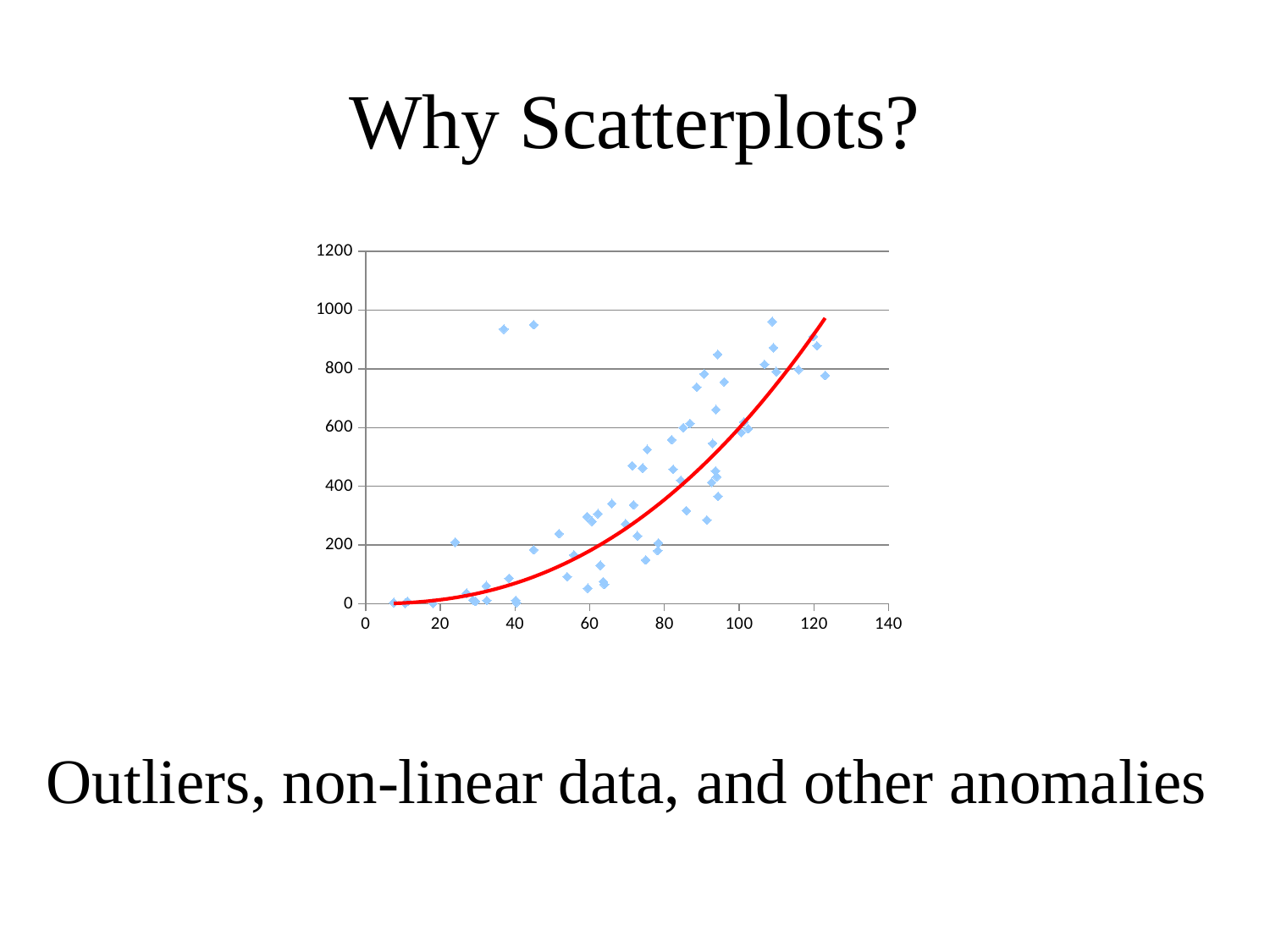
What is the highest value shown on the x-axis? 140 What colour is the fitted trend line on the chart? red What is the highest value shown on the y-axis? 1200 Is the highest plotted point greater or less than 800 on the y-axis? greater Is the lowest plotted point greater or less than 200 on the y-axis? less Is the highest plotted point greater or less than 1000 on the y-axis? less What kind of chart is shown on the slide? scatter chart Do the plotted values generally rise or fall as the x-axis value increases? rise